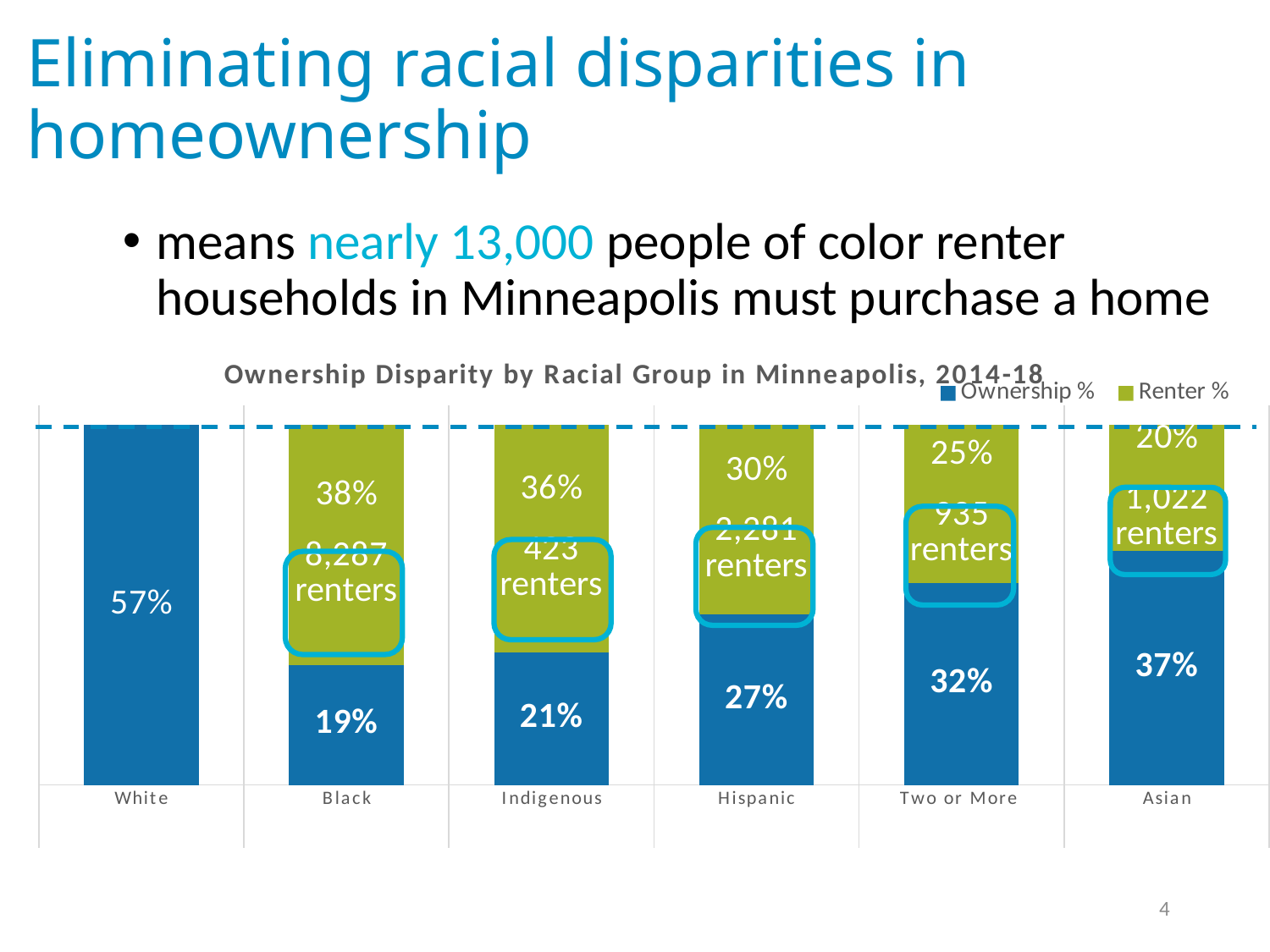
How many series does the legend list? 2 What is the Renter % for Hispanic households? 30% What is the difference in Ownership % between White and Black households? 38 percentage points What kind of chart is shown? Stacked bar chart Which racial group has the lowest Ownership %? Black How many racial groups are shown on the x axis? 6 What is the Ownership % for Asian households? 37% What is the total of the stacked bar for Indigenous (Ownership % plus Renter %)? 57% What is the Ownership % for Black households? 19% Which racial group has the highest Ownership %? White Which has a higher Ownership %, Asian or Two or More? Asian What is the title of the chart? Ownership Disparity by Racial Group in Minneapolis, 2014-18